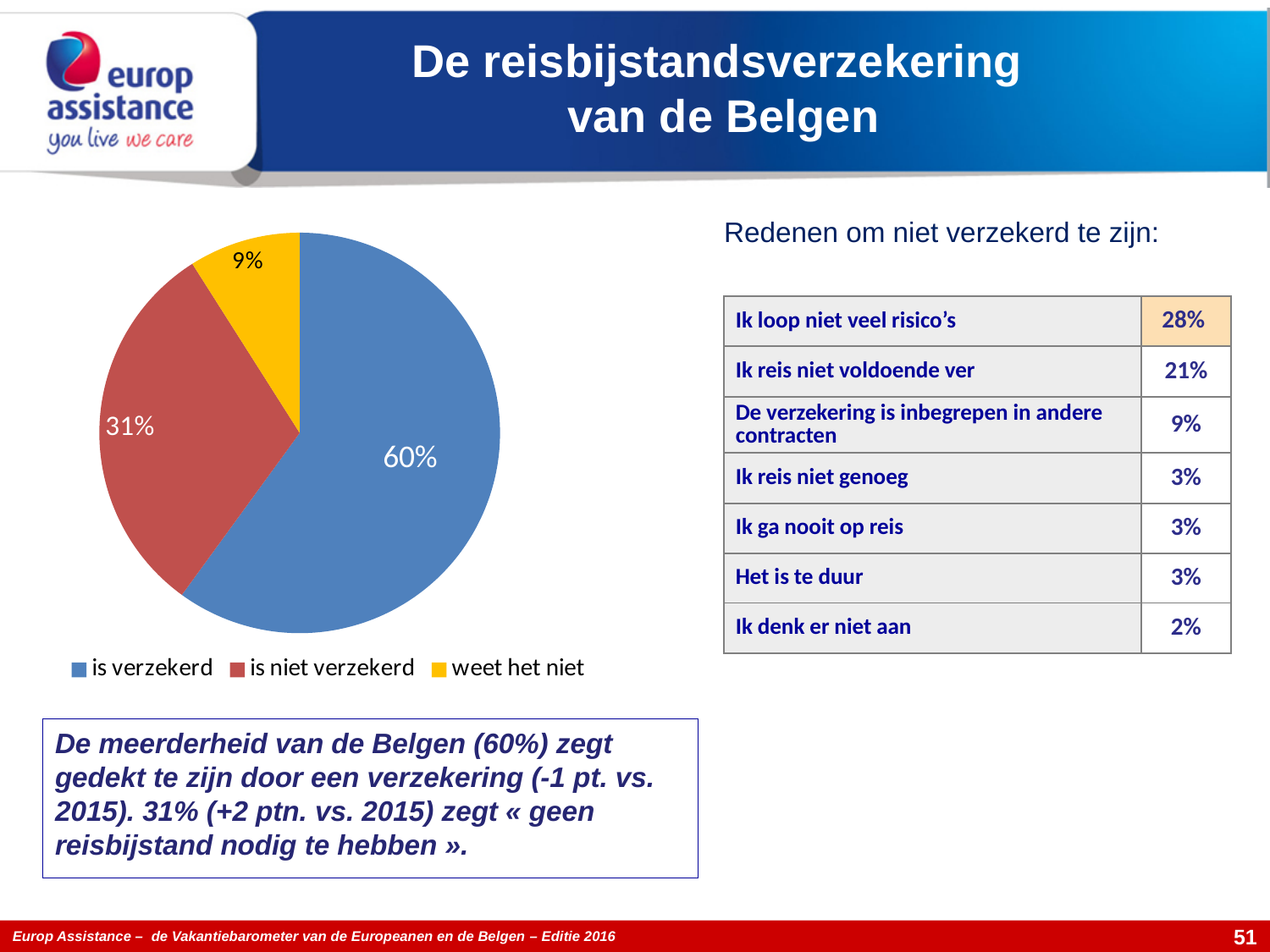
Which category has the smallest slice in the pie chart? weet het niet What share of the pie chart is 'weet het niet'? 9% What share of the pie chart is 'is niet verzekerd'? 31% How many entries does the legend of the pie chart list? 3 What colour is the 'weet het niet' slice in the pie chart? yellow Which category has the largest slice in the pie chart? is verzekerd Which is larger in the pie chart: 'is niet verzekerd' or 'weet het niet'? is niet verzekerd What colour is the 'is verzekerd' slice in the pie chart? blue What kind of chart is shown on the slide? pie chart What share of the pie chart is 'is verzekerd'? 60% How many slices does the pie chart have? 3 What is the difference in percentage points between 'is verzekerd' and 'is niet verzekerd'? 29